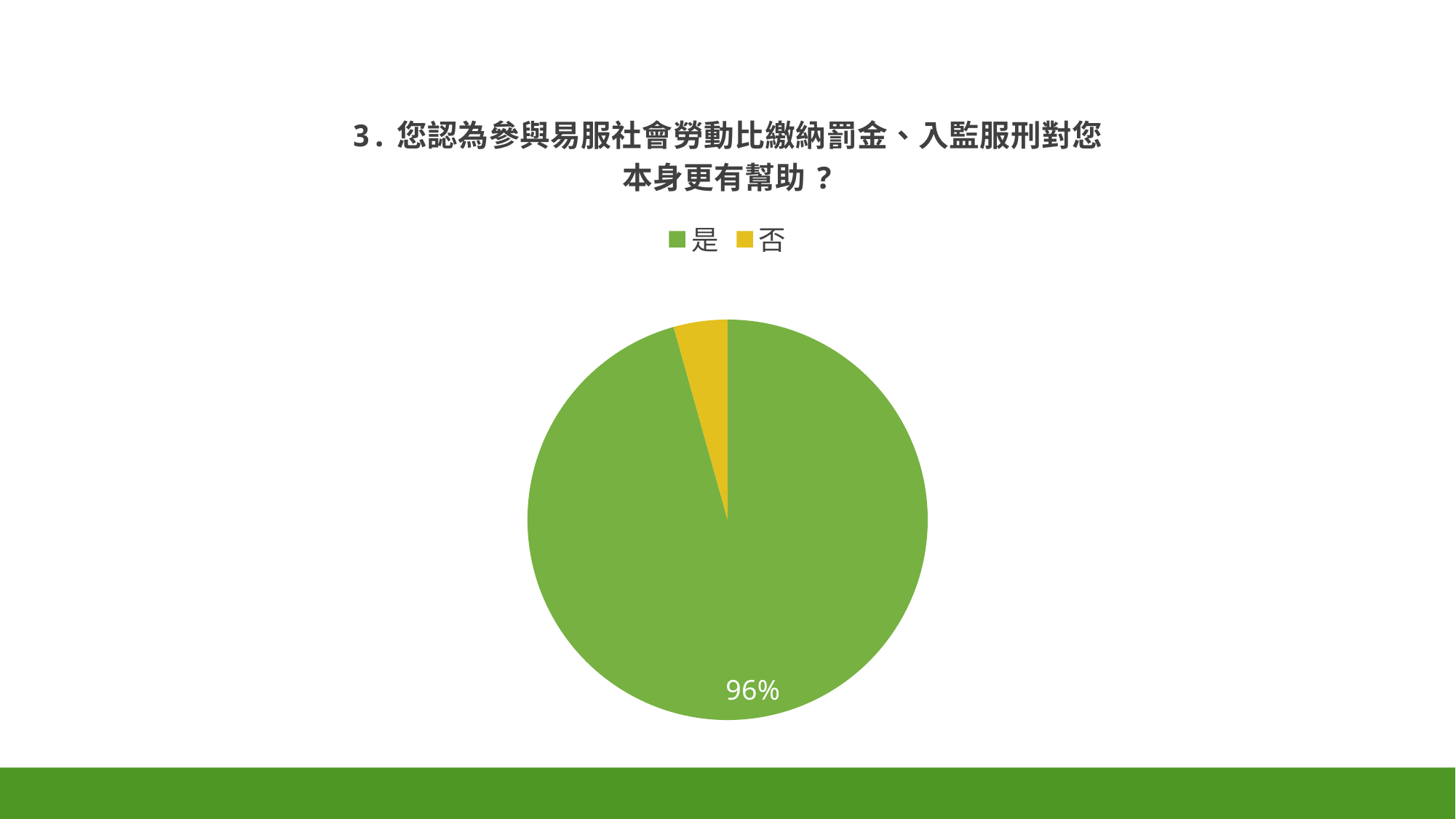
What colour is the 否 slice? yellow What kind of chart is shown on the slide? pie chart Which slice is larger, 是 or 否? 是 Which category has the largest slice of the pie? 是 What percentage of the pie is the 是 slice? 96% How many slices does the pie chart have? 2 Which category has the smallest slice of the pie? 否 What colour is the 是 slice? green How many entries does the legend list? 2 What share of the pie does the 是 slice take? 96%